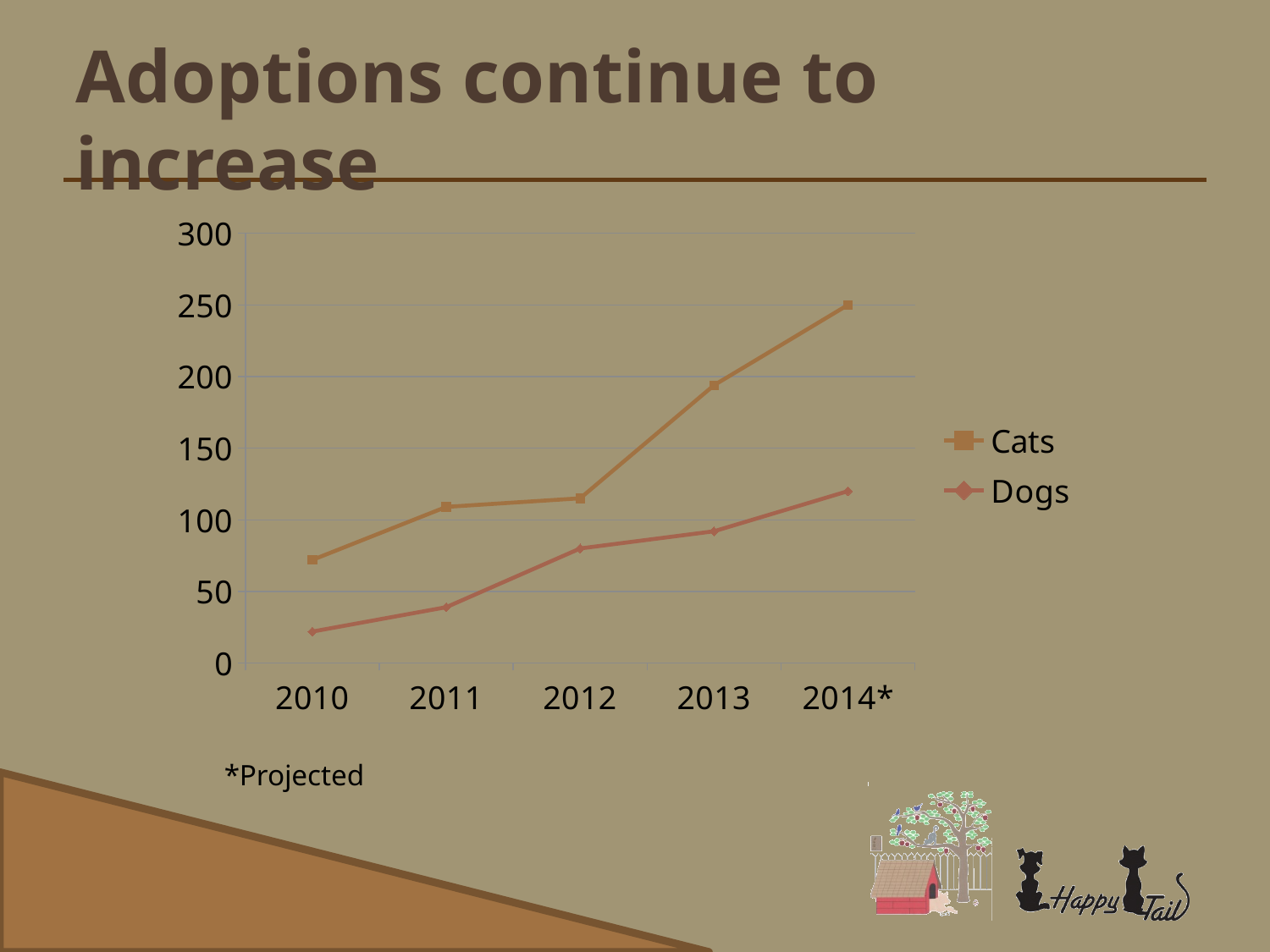
In 2013, which series has the larger value, Cats or Dogs? Cats How many years are plotted along the x axis? 5 Is the value for Dogs in 2014* greater or less than 100? greater What does the asterisk on 2014* indicate, according to the note below the chart? Projected How many series does the legend list? 2 In which year is the Cats series at its highest? 2014* Do the Cats adoption values rise or fall from 2010 to 2014*? rise Is the value for Dogs in 2012 greater or less than 50? greater Is the value for Cats in 2010 greater or less than 100? less In which year is the Dogs series at its lowest? 2010 What kind of chart is shown on the slide? line chart